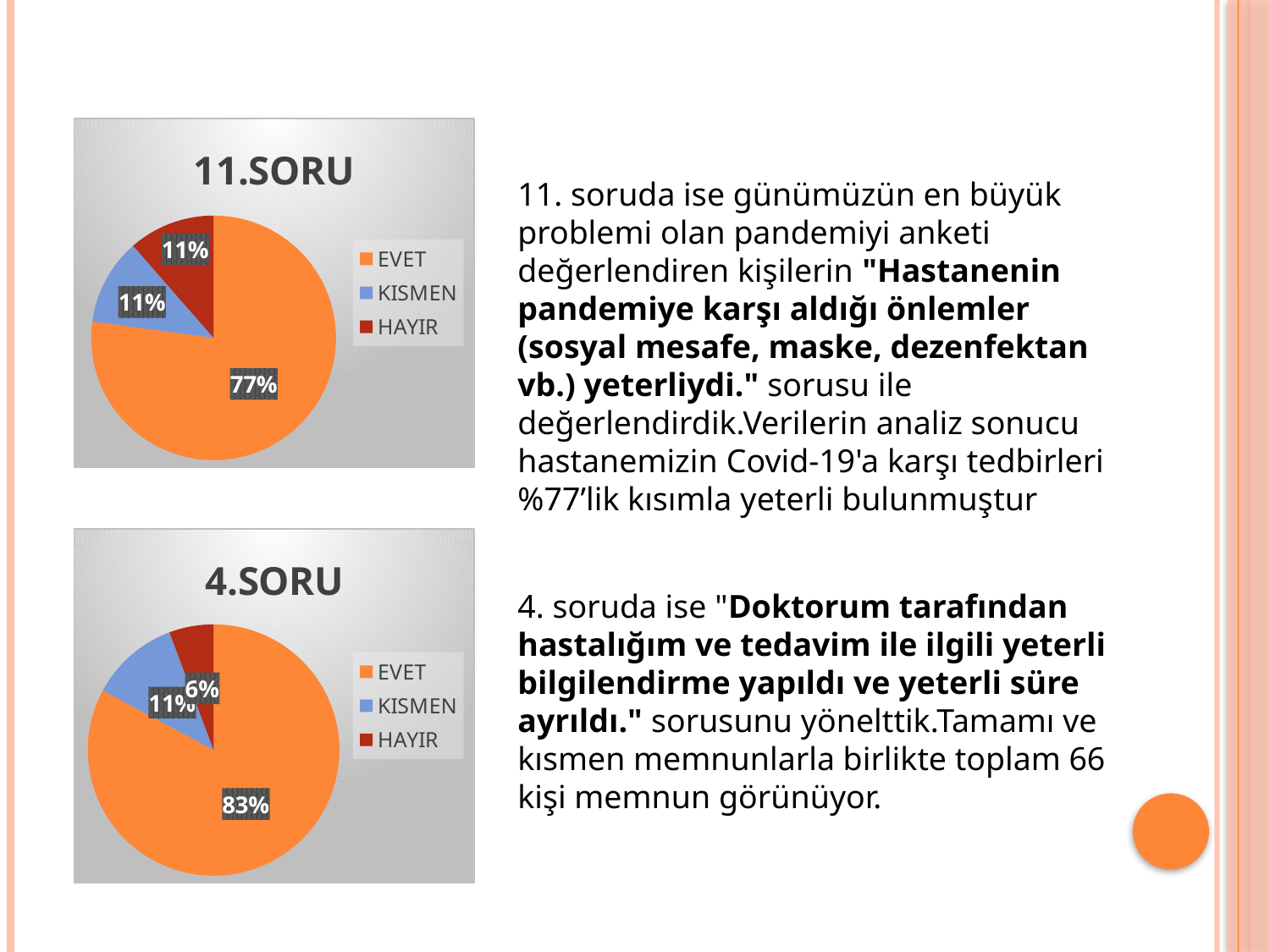
In the 11.SORU chart, what percentage is shown for HAYIR? 11% In the 4.SORU chart, what percentage is shown for HAYIR? 6% In the 11.SORU chart, what is the difference between the EVET and KISMEN percentages? 66% How many categories does the legend of the 11.SORU chart list? 3 In the 4.SORU chart, which is larger, KISMEN or HAYIR? KISMEN In the 4.SORU chart, which category has the smallest slice? HAYIR In the 4.SORU chart, what percentage is shown for EVET? 83% In the 11.SORU chart, what percentage is shown for EVET? 77% What type of chart is the 4.SORU chart? Pie chart In the 4.SORU chart, what is the difference between the EVET and HAYIR percentages? 77% In the 11.SORU chart, which category has the largest slice? EVET In the 11.SORU chart, what colour is the EVET slice? Orange